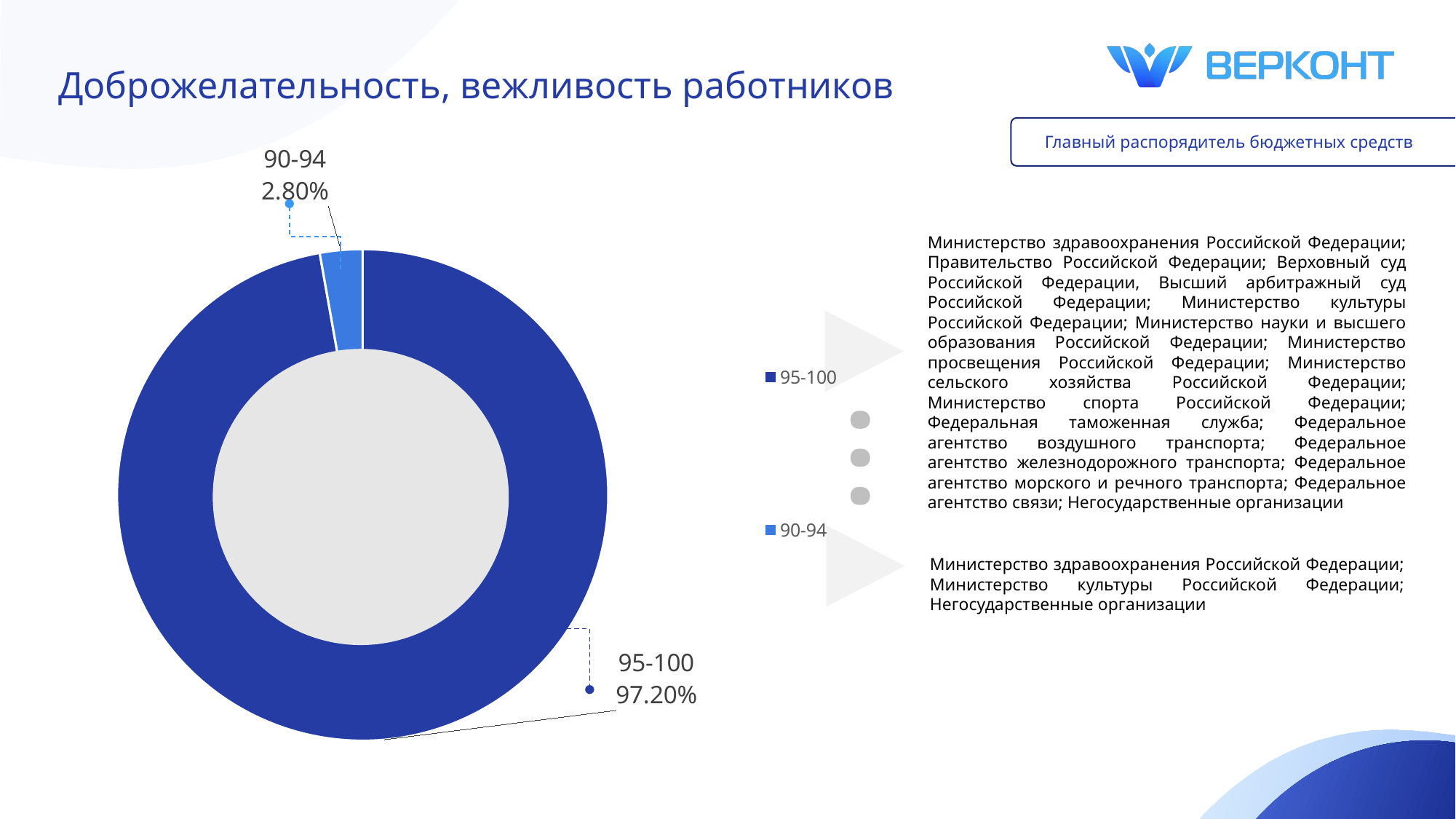
Which category has the larger share, 90-94 or 95-100? 95-100 What is the title of the slide containing the chart? Доброжелательность, вежливость работников How many categories are shown in the chart? 2 Which category has the smallest share in the chart? 90-94 How many entries does the chart legend list? 2 What is the total of the two shares shown in the chart? 100.00% What kind of chart is shown on the slide? Doughnut chart What share of the doughnut chart does the 90-94 category hold? 2.80% Which category has the largest share in the chart? 95-100 Which legend entry is shown in the lighter blue colour? 90-94 What share of the doughnut chart does the 95-100 category hold? 97.20% What is the difference in percentage points between the 95-100 share and the 90-94 share? 94.40%